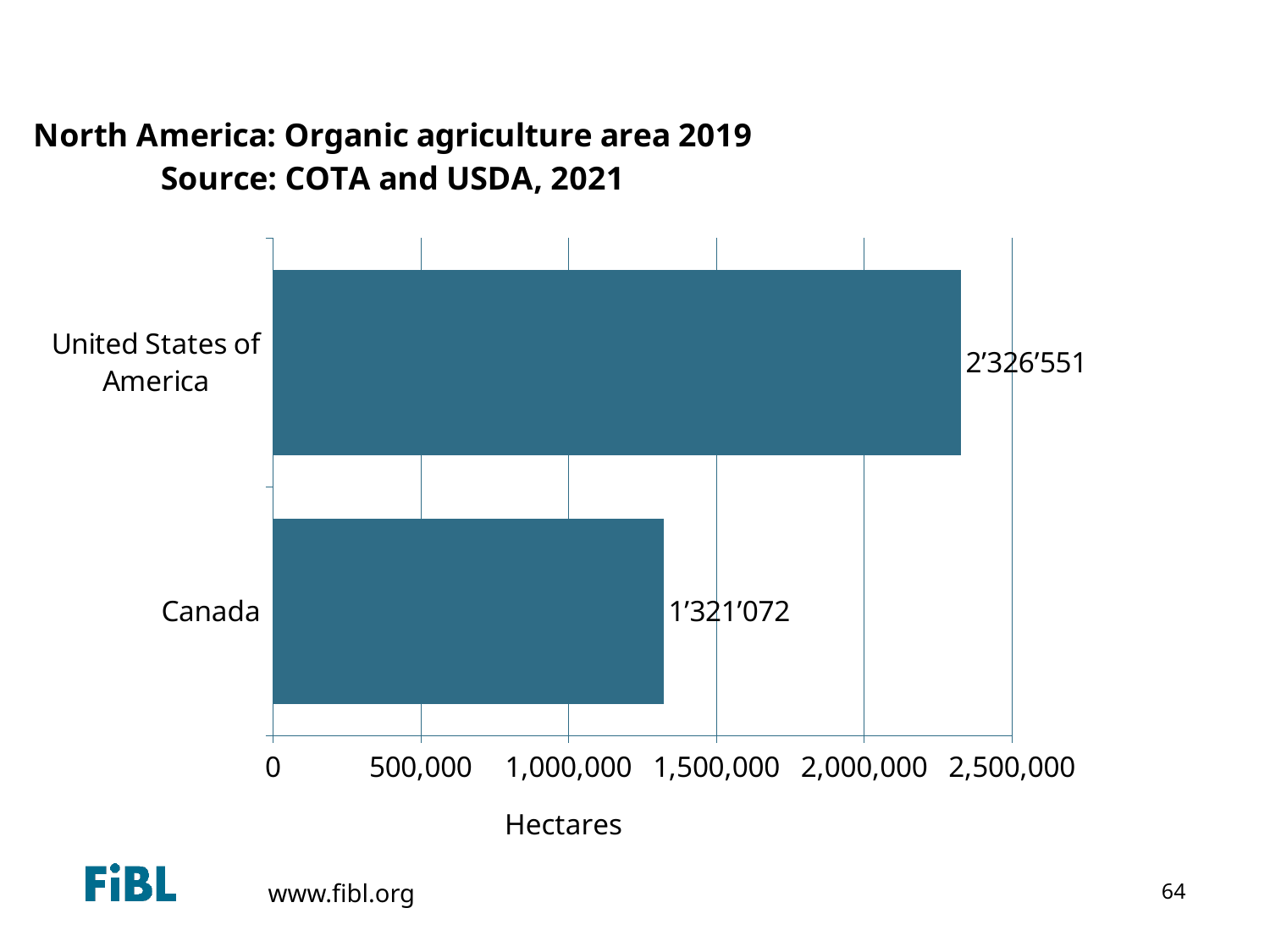
Is the value for Canada greater or less than 1,500,000? less What is the organic agriculture area for the United States of America? 2’326’551 What is the difference in organic agriculture area between the United States of America and Canada? 1’005’479 What unit is shown on the x axis? Hectares What is the organic agriculture area for Canada? 1’321’072 What is the title of the chart? North America: Organic agriculture area 2019 Is the value for the United States of America greater or less than 2,000,000? greater What kind of chart is shown on the slide? Bar chart How many countries are shown in the chart? 2 Which has a larger organic agriculture area, Canada or the United States of America? United States of America Which country has the largest organic agriculture area? United States of America Which country has the smallest organic agriculture area? Canada